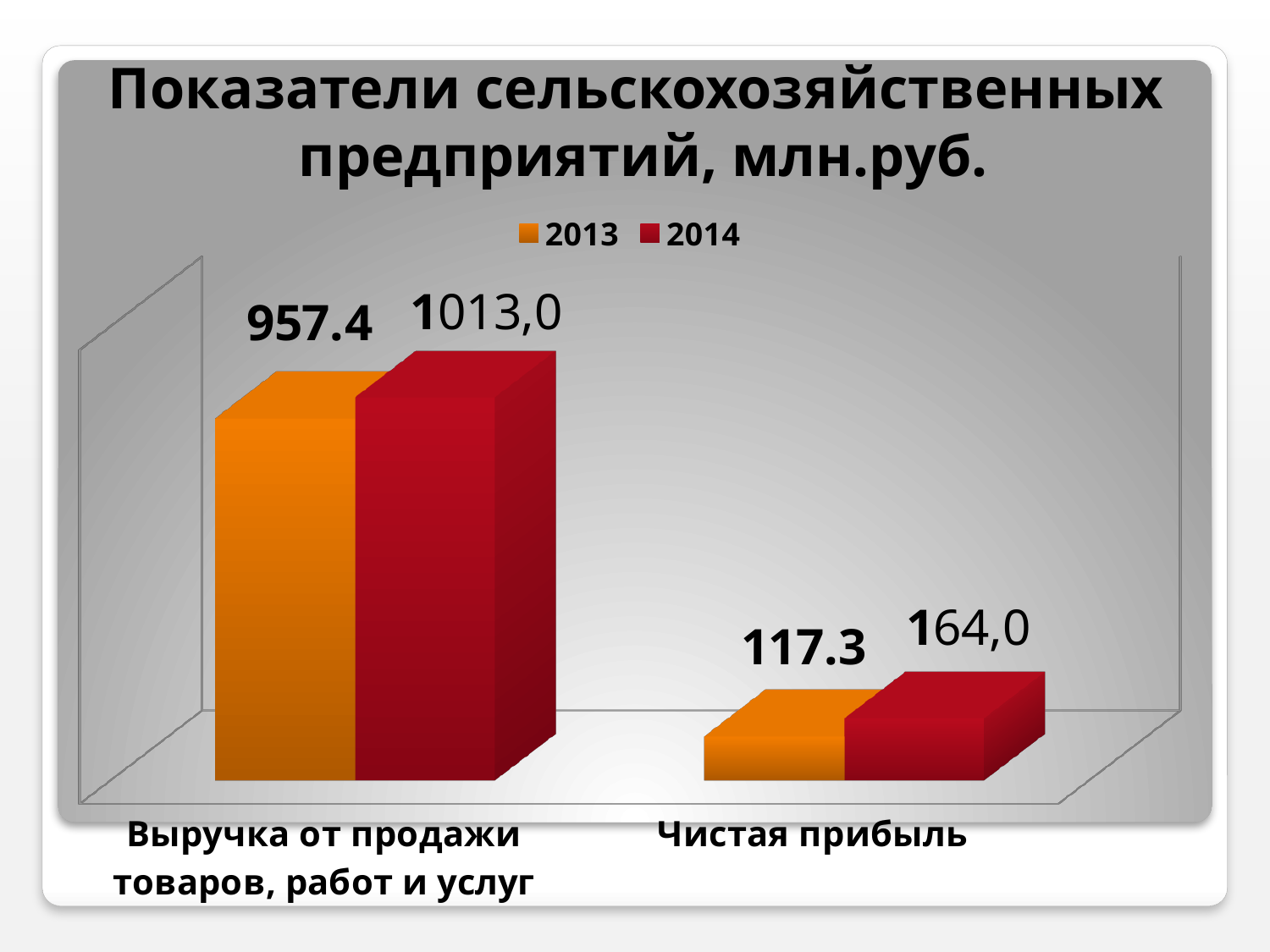
Which bar has the lowest value on the chart? 2013, Чистая прибыль What is the value for 2014 in the category 'Чистая прибыль'? 164,0 How many categories are shown on the x axis? 2 By how much does the 2014 value exceed the 2013 value for 'Чистая прибыль'? 46.7 Which is larger for 'Чистая прибыль': the 2013 value or the 2014 value? 2014 How many series does the legend list? 2 What is the value for 2014 in the category 'Выручка от продажи товаров, работ и услуг'? 1013,0 What is the value for 2013 in the category 'Выручка от продажи товаров, работ и услуг'? 957.4 Which bar has the highest value on the chart? 2014, Выручка от продажи товаров, работ и услуг What kind of chart is shown on the slide? Bar chart What is the value for 2013 in the category 'Чистая прибыль'? 117.3 What is the title of the chart? Показатели сельскохозяйственных предприятий, млн.руб.